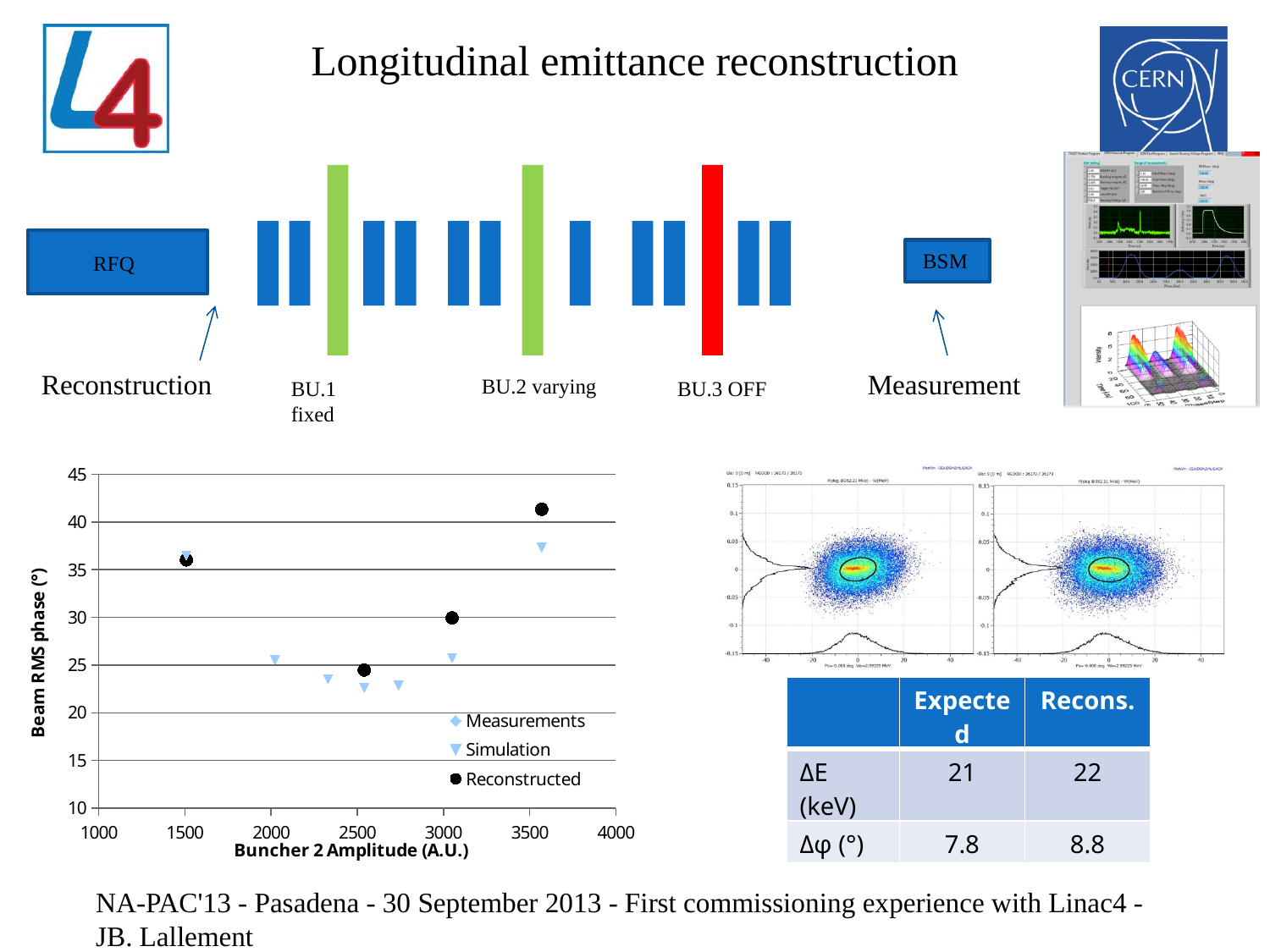
In the bottom-left chart, is the Simulation value at a Buncher 2 Amplitude of about 3550 greater or less than 40? less In the bottom-left chart, is the Simulation value at a Buncher 2 Amplitude of about 2500 greater or less than 25? less In the bottom-left chart, do the Reconstructed values rise or fall between the first point (about 1500) and the second point (about 2550)? fall In the bottom-left chart, is the Reconstructed value at a Buncher 2 Amplitude of about 1500 greater or less than 35? greater What is the title of the x axis of the bottom-left chart? Buncher 2 Amplitude (A.U.) In the bottom-left chart, at a Buncher 2 Amplitude of about 3550, which is larger: the Reconstructed value or the Simulation value? Reconstructed How many series does the legend of the bottom-left chart list? 3 What kind of chart is shown at the bottom left of the slide? scatter chart How many Reconstructed (black circle) points are plotted in the bottom-left chart? 4 What are the three series named in the legend of the bottom-left chart? Measurements, Simulation, Reconstructed